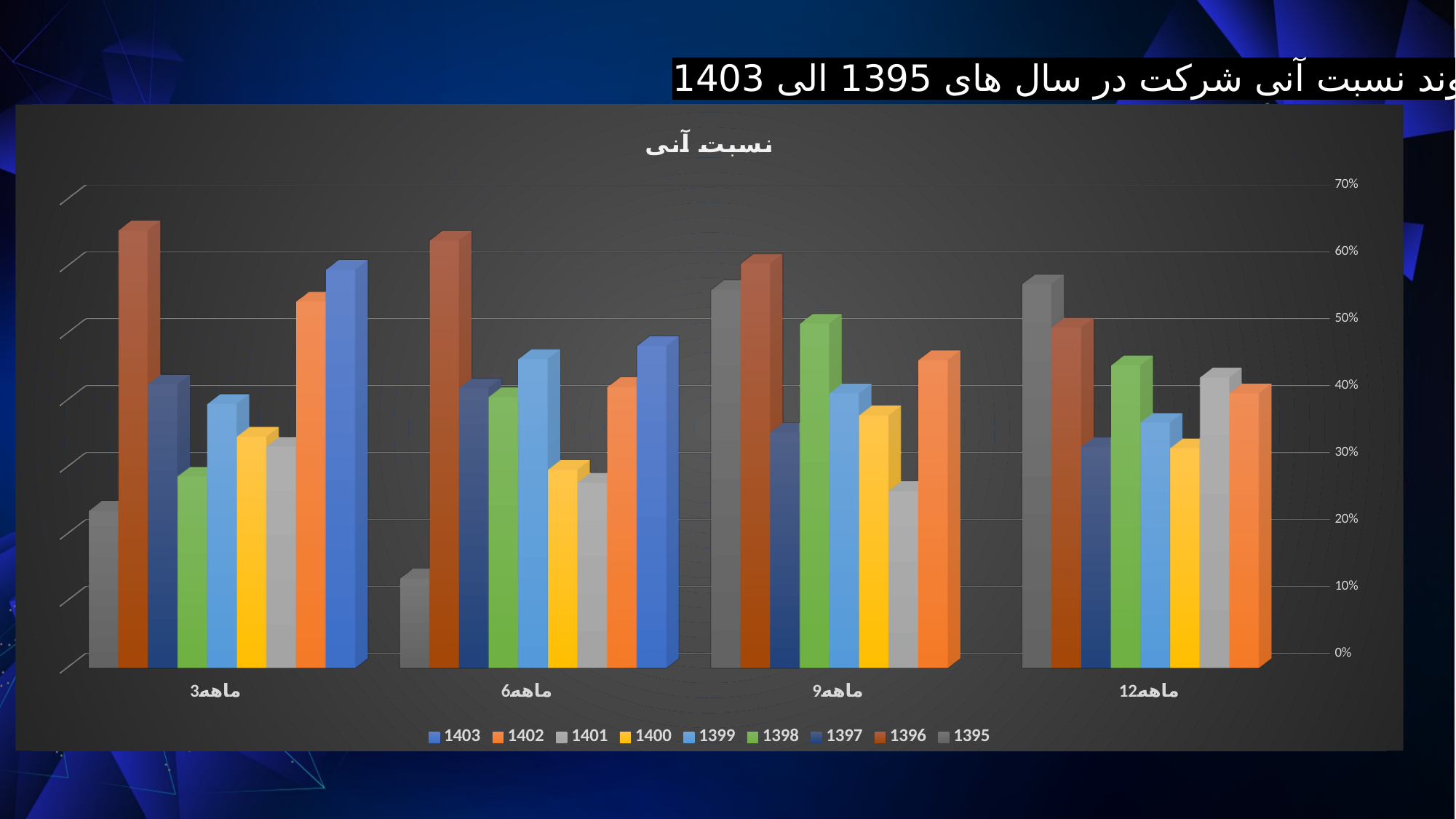
In the 3ماهه category, which is larger: the value for 1403 or the value for 1398? 1403 What kind of chart is shown on the slide? bar chart Which series has the lowest value in the 6ماهه category? 1395 What is the title of the chart? نسبت آنی Is the value for 1396 in the 3ماهه category greater or less than 60%? greater How many series does the legend list? 9 Is the value for 1395 in the 6ماهه category greater or less than 20%? less Which series has the highest value in the 3ماهه category? 1396 In the 12ماهه category, which is larger: the value for 1395 or the value for 1397? 1395 How many categories are shown on the x axis of the chart? 4 Does the value for the 1396 series rise or fall from 3ماهه to 12ماهه? fall Is the value for 1398 in the 9ماهه category greater or less than 40%? greater